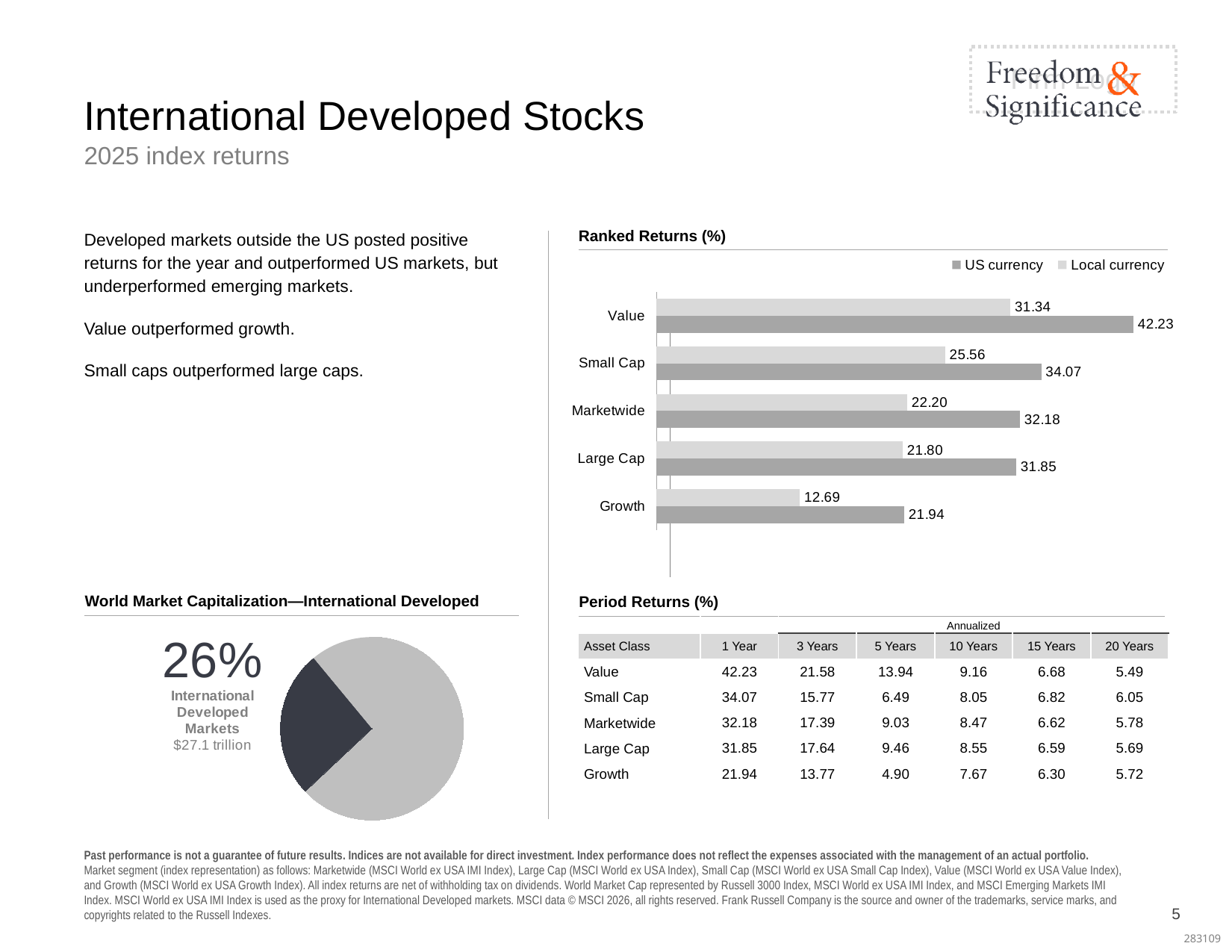
In the Ranked Returns (%) chart, what is the Local currency return for Growth? 12.69 In the Ranked Returns (%) chart, what is the Local currency return for Marketwide? 22.20 In the Ranked Returns (%) chart, what is the US currency return for Value? 42.23 In the Ranked Returns (%) chart, which category has the lowest Local currency return? Growth In the Ranked Returns (%) chart, which category has the highest US currency return? Value How many categories are shown in the Ranked Returns (%) chart? 5 In the Ranked Returns (%) chart, what is the difference between the US currency and Local currency returns for Small Cap? 8.51 What kind of chart is the World Market Capitalization—International Developed chart? Pie chart In the World Market Capitalization—International Developed chart, what share of the pie do International Developed Markets represent? 26% In the Ranked Returns (%) chart, which is larger: the US currency return for Large Cap or the US currency return for Growth? Large Cap What kind of chart is the Ranked Returns (%) chart? Bar chart How many series does the legend of the Ranked Returns (%) chart list? 2